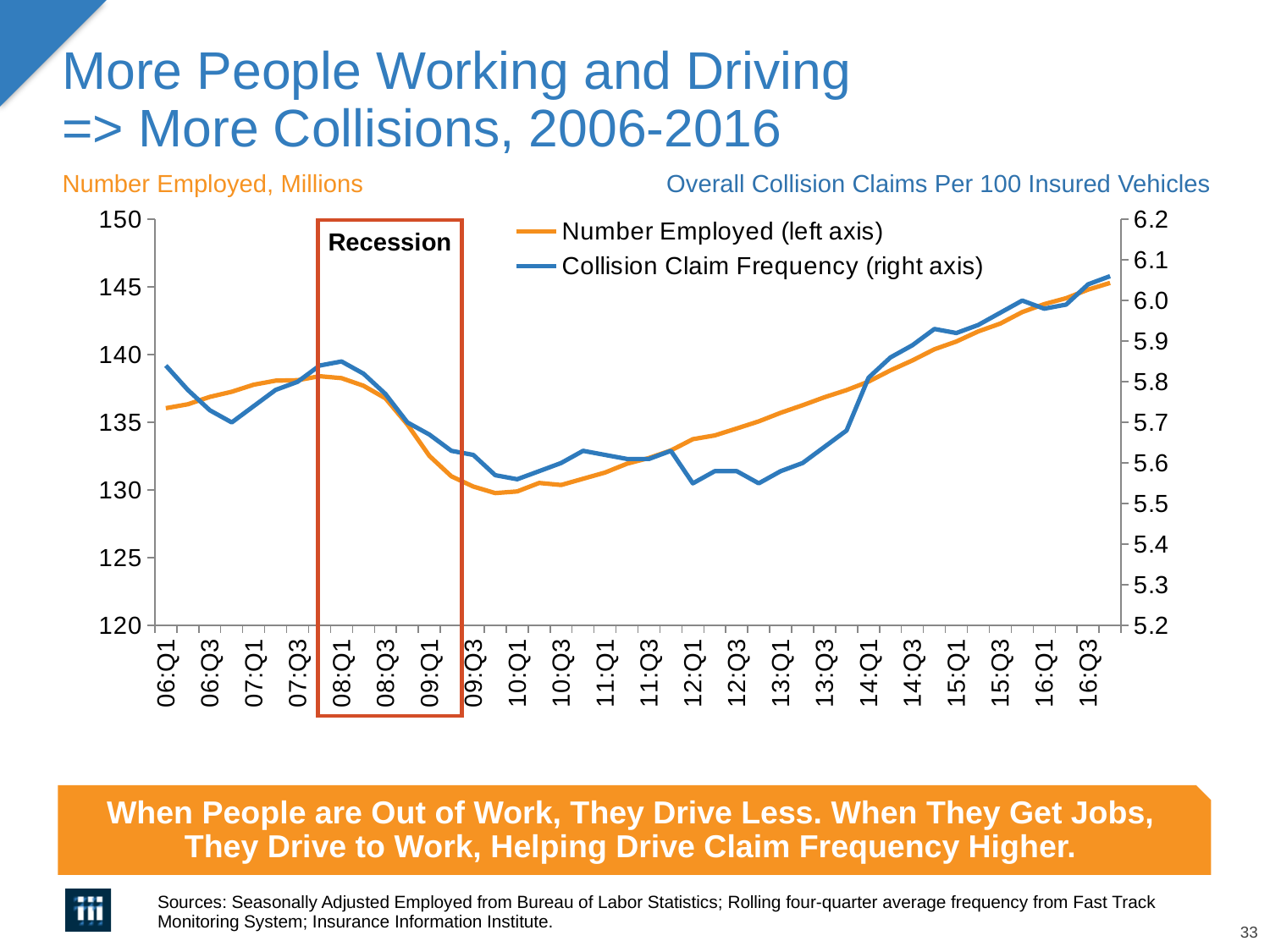
Is the value for Collision Claim Frequency at 16:Q3 greater or less than 6.0? greater What label appears in the red box on the chart? Recession Does the Number Employed line rise or fall between 08:Q1 and 09:Q3? Fall Is the value for Number Employed at 06:Q1 greater or less than 135? greater Is the value for Number Employed at 14:Q1 greater or less than 135? greater Which series is plotted against the right axis? Collision Claim Frequency At which quarter does the Number Employed line reach its highest value? 16:Q4 What kind of chart is shown on the slide? Line chart Does the Collision Claim Frequency line rise or fall between 13:Q3 and 16:Q3? Rise How many series does the legend list? 2